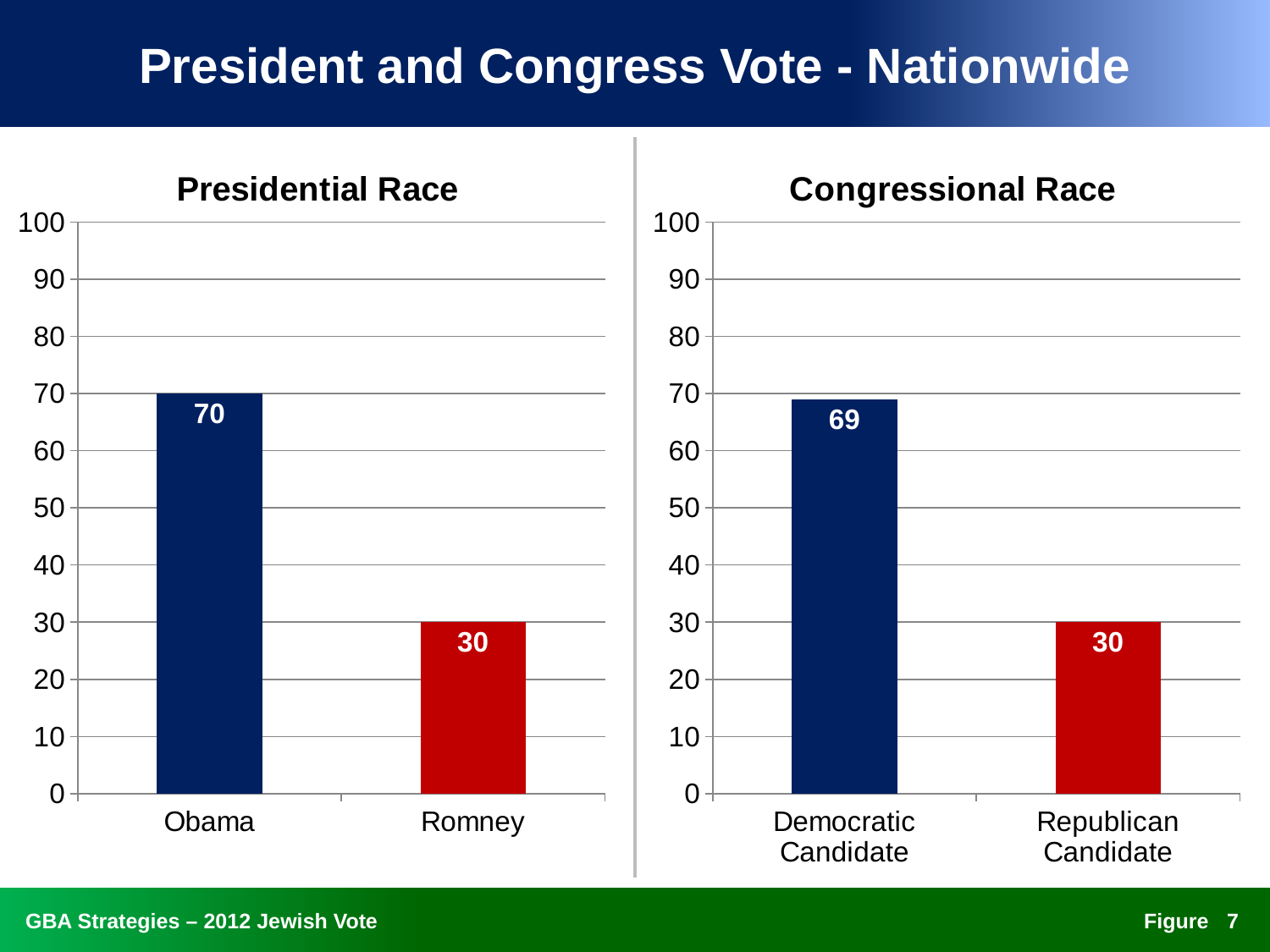
In the Congressional Race chart, which category has the lowest value? Republican Candidate What kind of chart is the Congressional Race chart? Bar chart In the Presidential Race chart, what is the value for Romney? 30 In the Congressional Race chart, what is the difference between the values for the Democratic Candidate and the Republican Candidate? 39 In the Congressional Race chart, which is larger, the value for the Democratic Candidate or the Republican Candidate? Democratic Candidate How many categories are shown in the Presidential Race chart? 2 In the Presidential Race chart, what is the difference between the values for Obama and Romney? 40 In the Presidential Race chart, what is the value for Obama? 70 In the Congressional Race chart, what is the value for the Republican Candidate? 30 In the Congressional Race chart, what is the value for the Democratic Candidate? 69 What is the title of the chart on the left side of the slide? Presidential Race In the Presidential Race chart, which category has the highest value? Obama